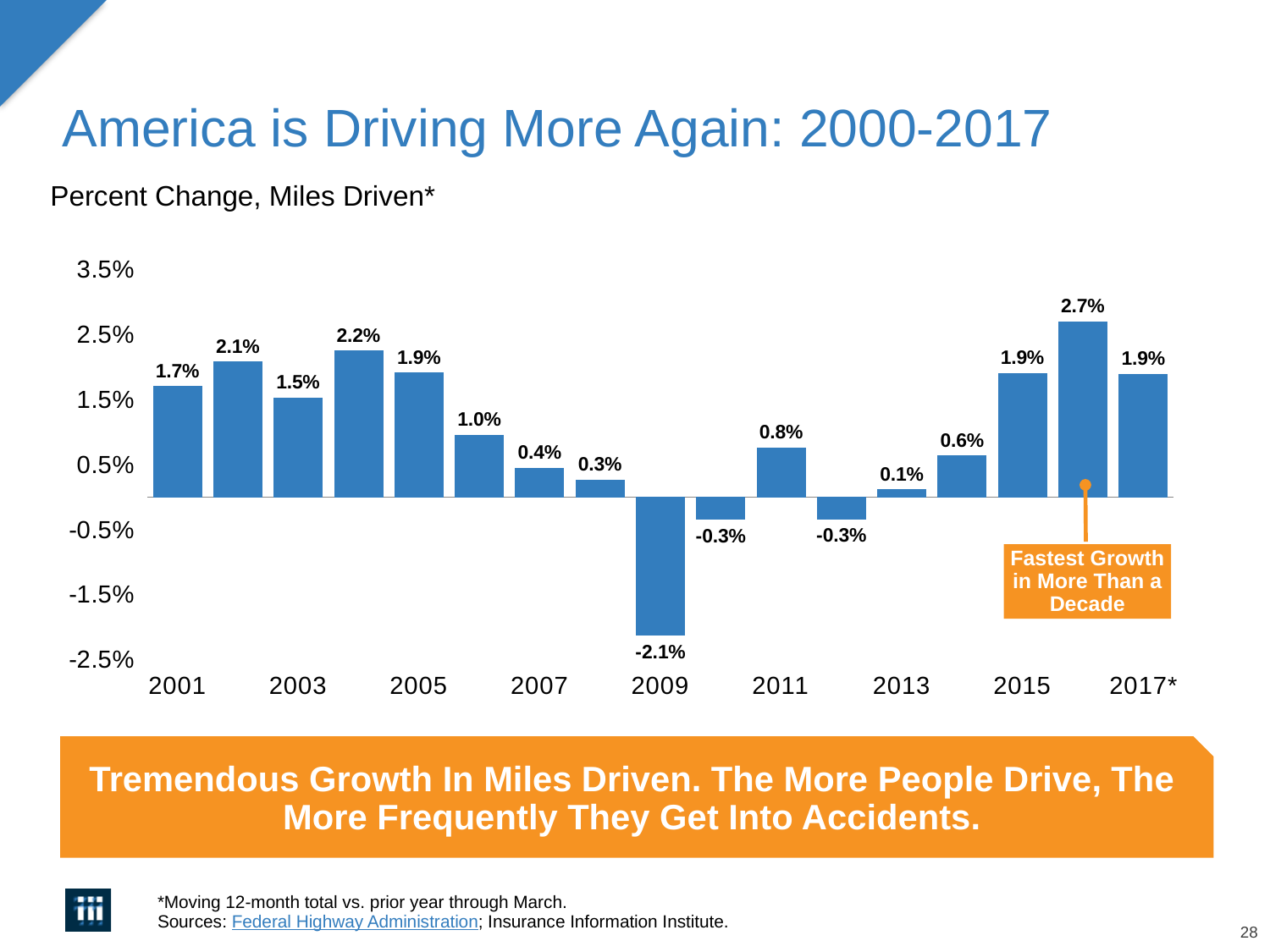
Do the values rise or fall from 2013 to 2015? Rise Which year has the larger percent change, 2005 or 2011? 2005 How many bars are plotted on the chart? 17 What is the percent change in miles driven for 2009? -2.1% Which year has the lowest percent change in miles driven? 2009 What is the difference between the percent change for 2015 and for 2013? 1.8% What is the percent change in miles driven for 2013? 0.1% What is the percent change in miles driven for 2001? 1.7% What is the highest percent change value shown on the chart? 2.7% What type of chart is shown on the slide? Bar chart What is the percent change in miles driven for 2017*? 1.9% What does the orange callout box on the chart say? Fastest Growth in More Than a Decade